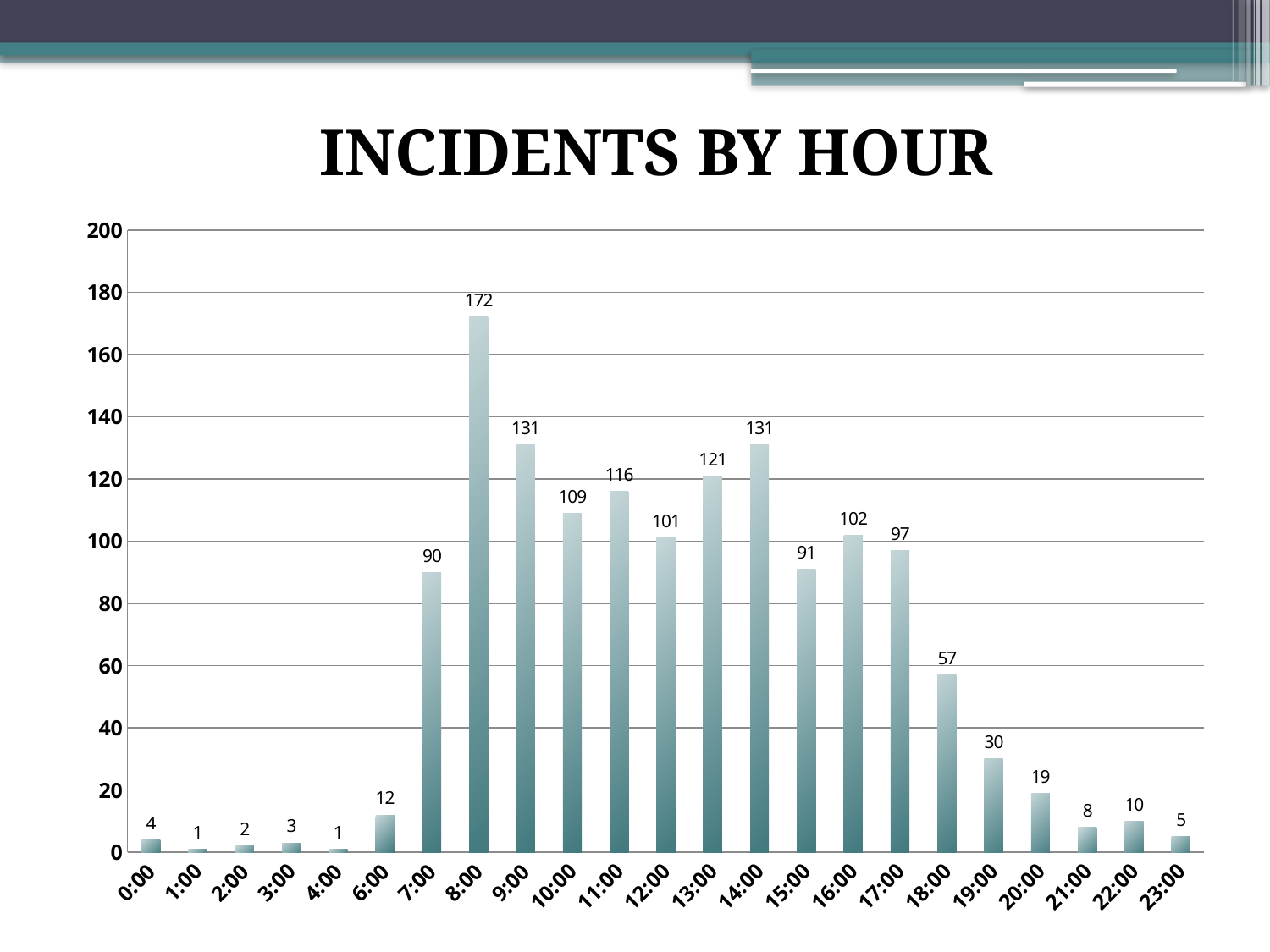
Is the value for 7:00 greater or less than 80? greater What is the value for 8:00? 172 What is the difference between the values for 8:00 and 9:00? 41 What is the value for 14:00? 131 What is the value for 18:00? 57 What is the difference between the values for 16:00 and 15:00? 11 How many hour categories are shown on the x axis? 23 Which is larger, the value for 11:00 or the value for 12:00? 11:00 What is the value for 6:00? 12 Do the values rise or fall from 17:00 to 21:00? fall What kind of chart is this? bar chart Which hour has the highest number of incidents? 8:00